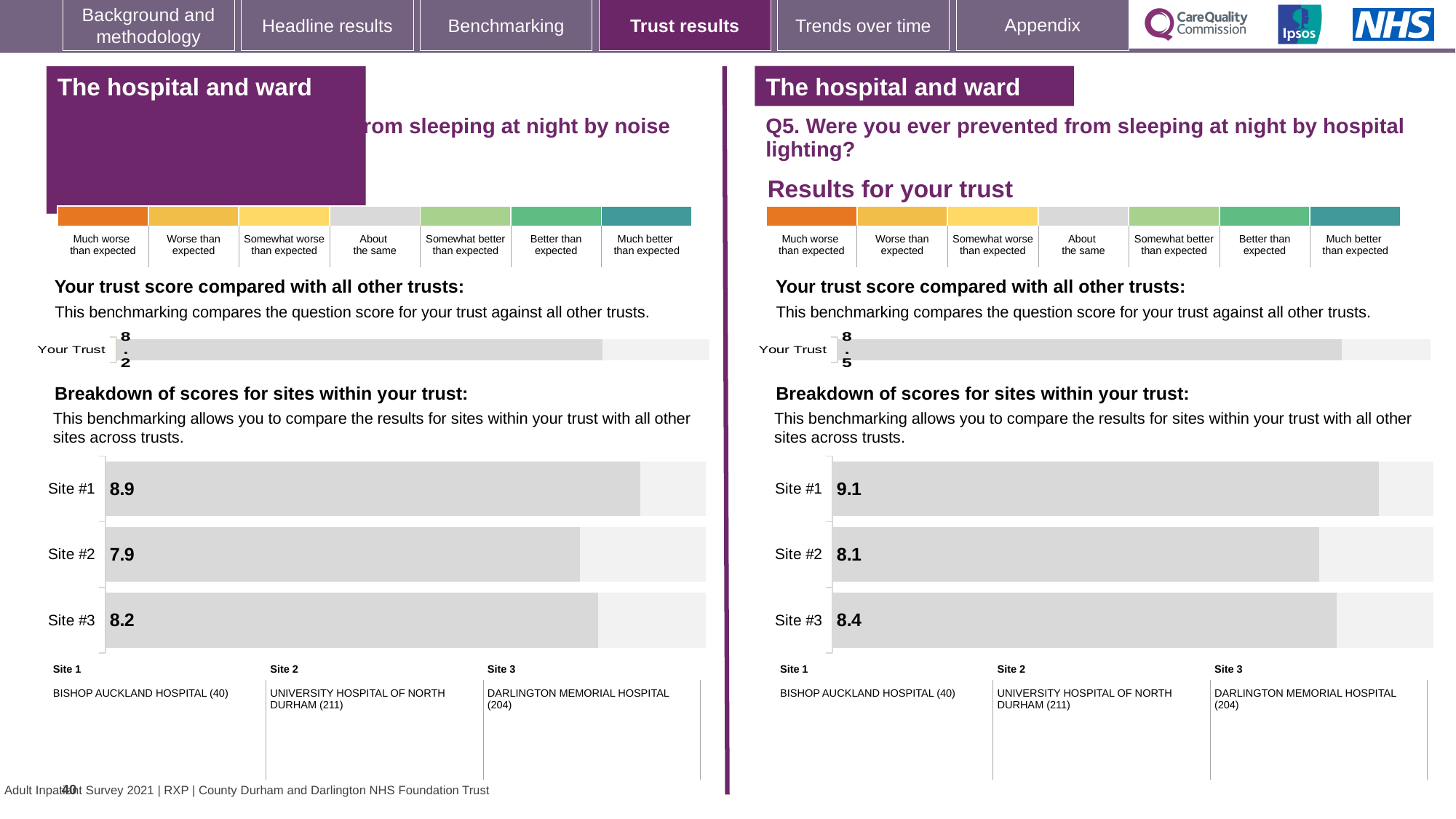
In the left-hand panel (sleeping at night by noise), what is the 'Your Trust' score in the trust comparison bar? 8.2 In the left-hand panel (sleeping at night by noise), what is the score shown for Site #2? 7.9 In the left-hand panel (sleeping at night by noise), which site has the lowest score in the site breakdown chart? Site #2 In the left-hand panel (sleeping at night by noise), what is the score shown for Site #1 in the breakdown of scores for sites within your trust? 8.9 How many sites are shown in the site breakdown chart in the right-hand panel (Q5, hospital lighting)? 3 In the right-hand panel (Q5, hospital lighting), what is the score shown for Site #1? 9.1 In the right-hand panel (Q5, hospital lighting), what is the 'Your Trust' score in the trust comparison bar? 8.5 In the right-hand panel (Q5, hospital lighting), is the Site #2 score larger or smaller than the Site #3 score? smaller What kind of chart is used for the breakdown of scores for sites within your trust in the left-hand panel? bar chart In the left-hand panel (sleeping at night by noise), what is the difference between the Site #1 and Site #2 scores? 1.0 In the right-hand panel (Q5, hospital lighting), which site has the highest score in the site breakdown chart? Site #1 In the right-hand panel (Q5, hospital lighting), what is the score shown for Site #3? 8.4